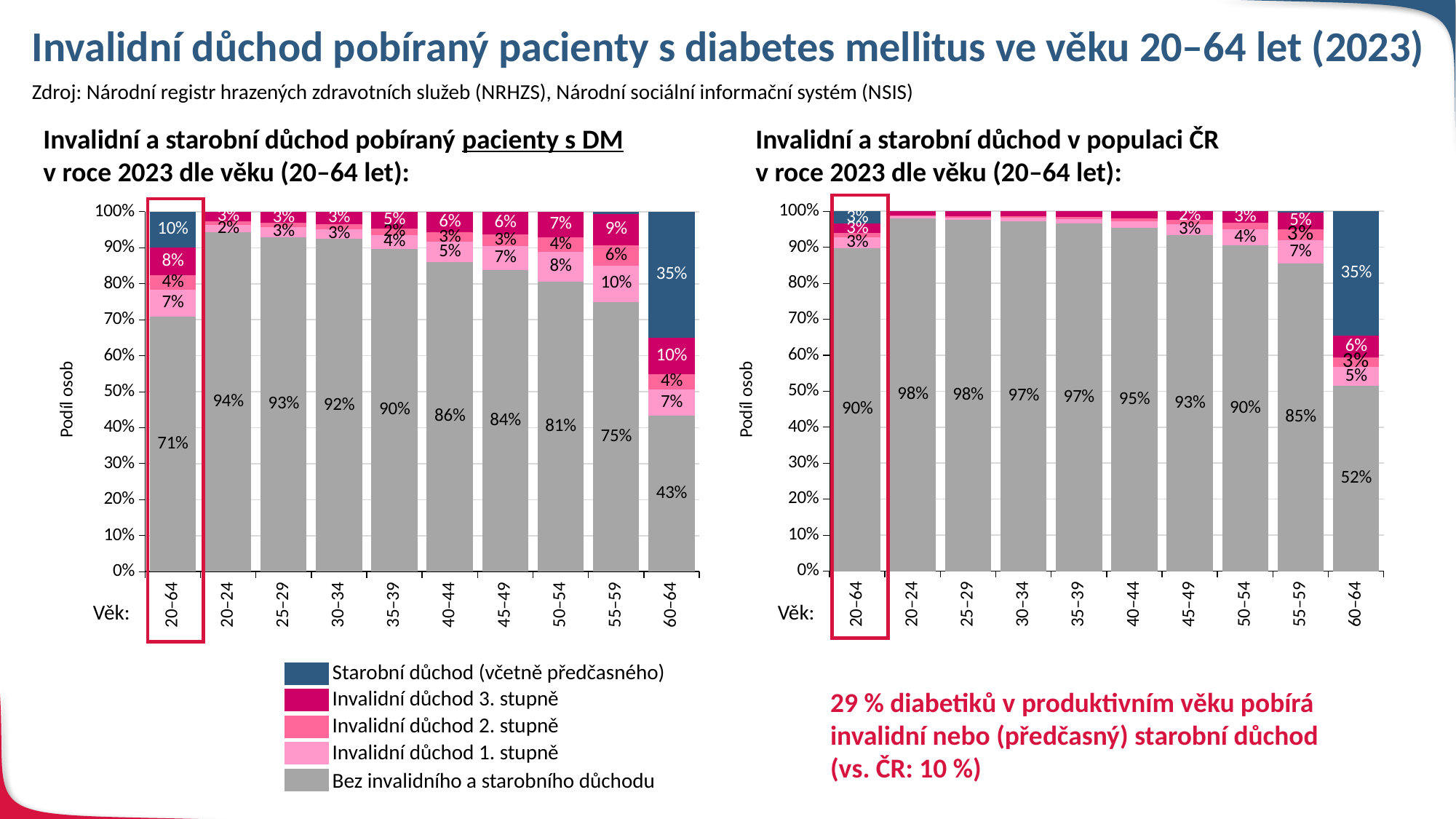
What is the difference between the share without pension for the 20–64 group in the right chart (90%) and in the left chart (71%)? 19 percentage points In the left chart (pacienty s DM), what is the share of Starobní důchod for the 60–64 age group? 35% In the left chart (pacienty s DM), which age group has the lowest share of people without invalidity or old-age pension? 60–64 How many age categories are shown on the x axis of the left chart? 10 What type of chart is used on the slide? Stacked bar chart In the left chart (pacienty s DM), is the share of Invalidní důchod 1. stupně larger for 55–59 or for 50–54? 55–59 In the right chart (populace ČR), what share of the 20–64 group has no invalidity or old-age pension? 90% Which series is shown in dark blue in the legend? Starobní důchod (včetně předčasného) In the right chart (populace ČR), which age group has the highest share of Invalidní důchod 3. stupně? 60–64 In the left chart (pacienty s DM), does the share without invalidity or old-age pension rise or fall from the 20–24 group to the 60–64 group? Fall In the left chart (pacienty s DM), what share of the 20–64 group has no invalidity or old-age pension (Bez invalidního a starobního důchodu)? 71% How many series does the legend list? 5